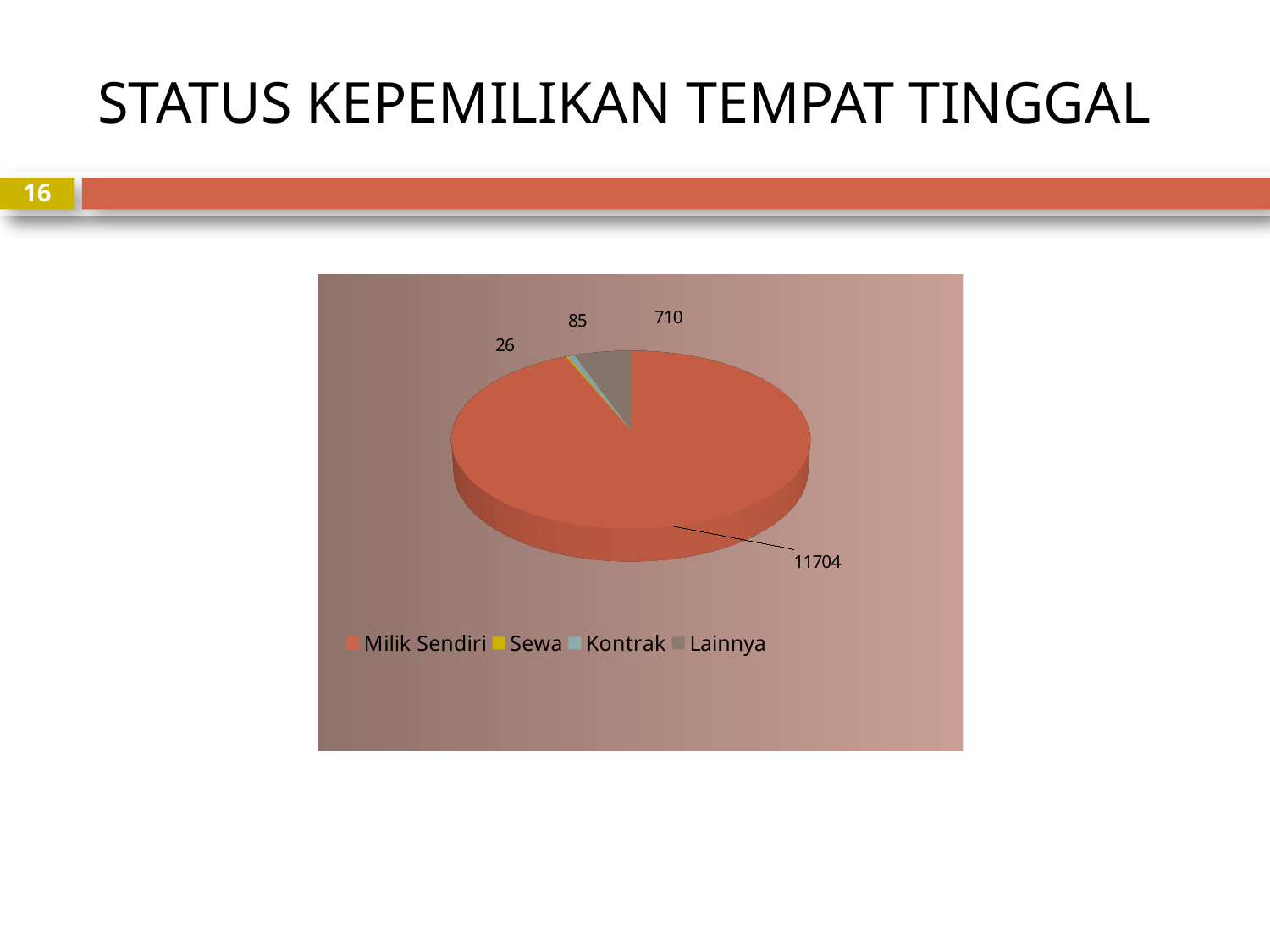
What is the value for Milik Sendiri? 11704 What is the value for Kontrak? 85 What is the difference between the values for Milik Sendiri and Lainnya? 10994 What is the difference between the values for Lainnya and Kontrak? 625 What type of chart is shown on the slide? pie chart Which category has the smallest slice of the pie? Sewa What is the total of all the slices in the pie? 12525 Which is larger, the value for Kontrak or the value for Sewa? Kontrak Which category has the largest slice of the pie? Milik Sendiri What is the value for Sewa? 26 How many categories does the legend list? 4 What is the value for Lainnya? 710